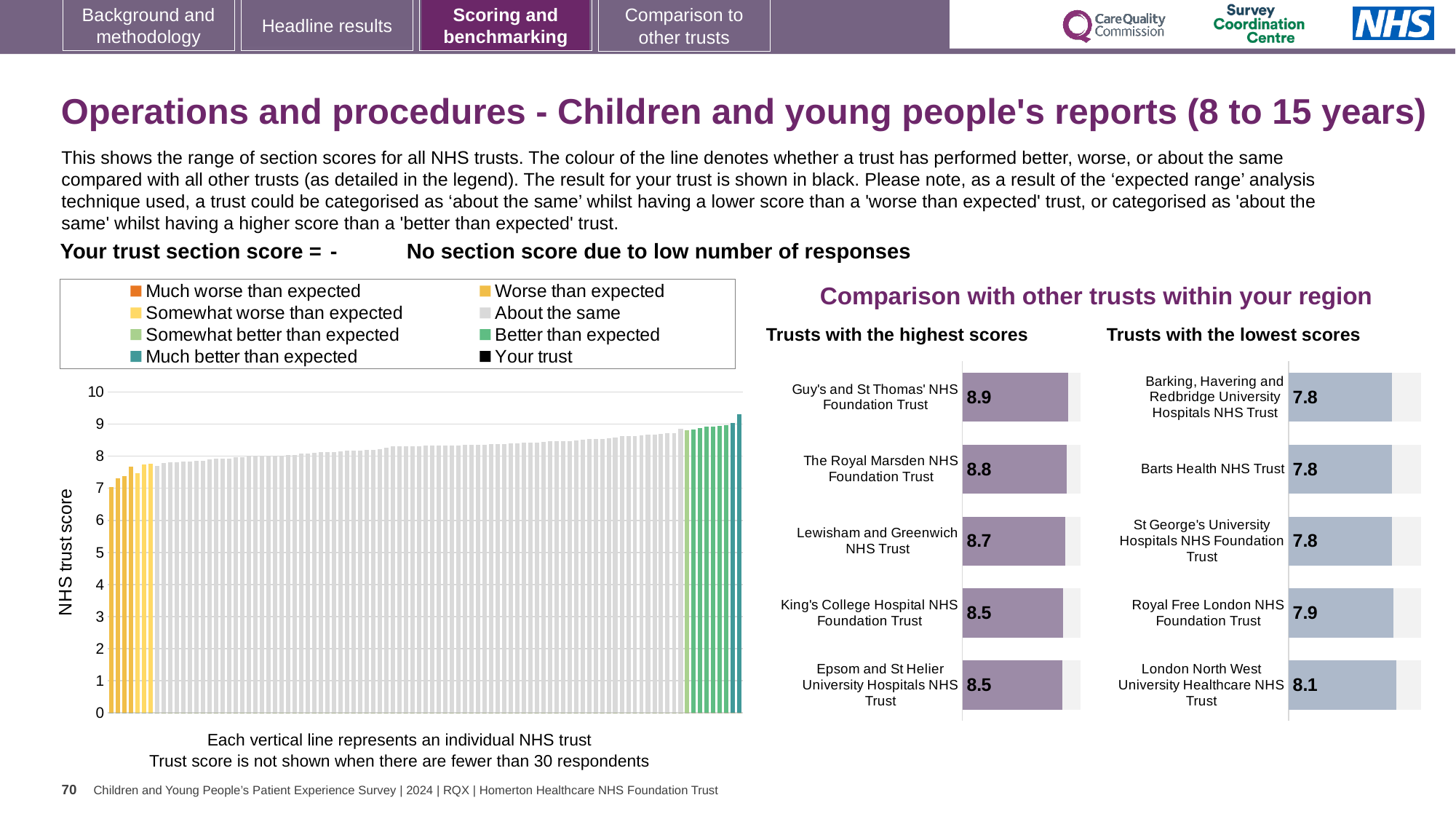
In the 'Trusts with the highest scores' chart, which trust has the highest score? Guy's and St Thomas' NHS Foundation Trust In the 'Trusts with the lowest scores' chart, which has the larger score: Royal Free London NHS Foundation Trust or Barts Health NHS Trust? Royal Free London NHS Foundation Trust In the large chart on the left showing the range of section scores, do the values rise or fall from left to right? rise In the 'Trusts with the highest scores' chart, what is the difference between the scores of Guy's and St Thomas' NHS Foundation Trust and Epsom and St Helier University Hospitals NHS Trust? 0.4 In the 'Trusts with the lowest scores' chart, what is the score for Royal Free London NHS Foundation Trust? 7.9 In the large chart on the left showing the range of section scores, is the value of the leftmost bar greater or less than 8? less In the 'Trusts with the highest scores' chart, how many trusts are shown? 5 In the 'Trusts with the highest scores' chart, what is the score for Guy's and St Thomas' NHS Foundation Trust? 8.9 In the 'Trusts with the highest scores' chart, what is the score for Lewisham and Greenwich NHS Trust? 8.7 In the 'Trusts with the lowest scores' chart, which trust has the highest score? London North West University Healthcare NHS Trust How many entries does the legend above the large chart on the left list? 8 In the 'Trusts with the lowest scores' chart, what is the score for London North West University Healthcare NHS Trust? 8.1